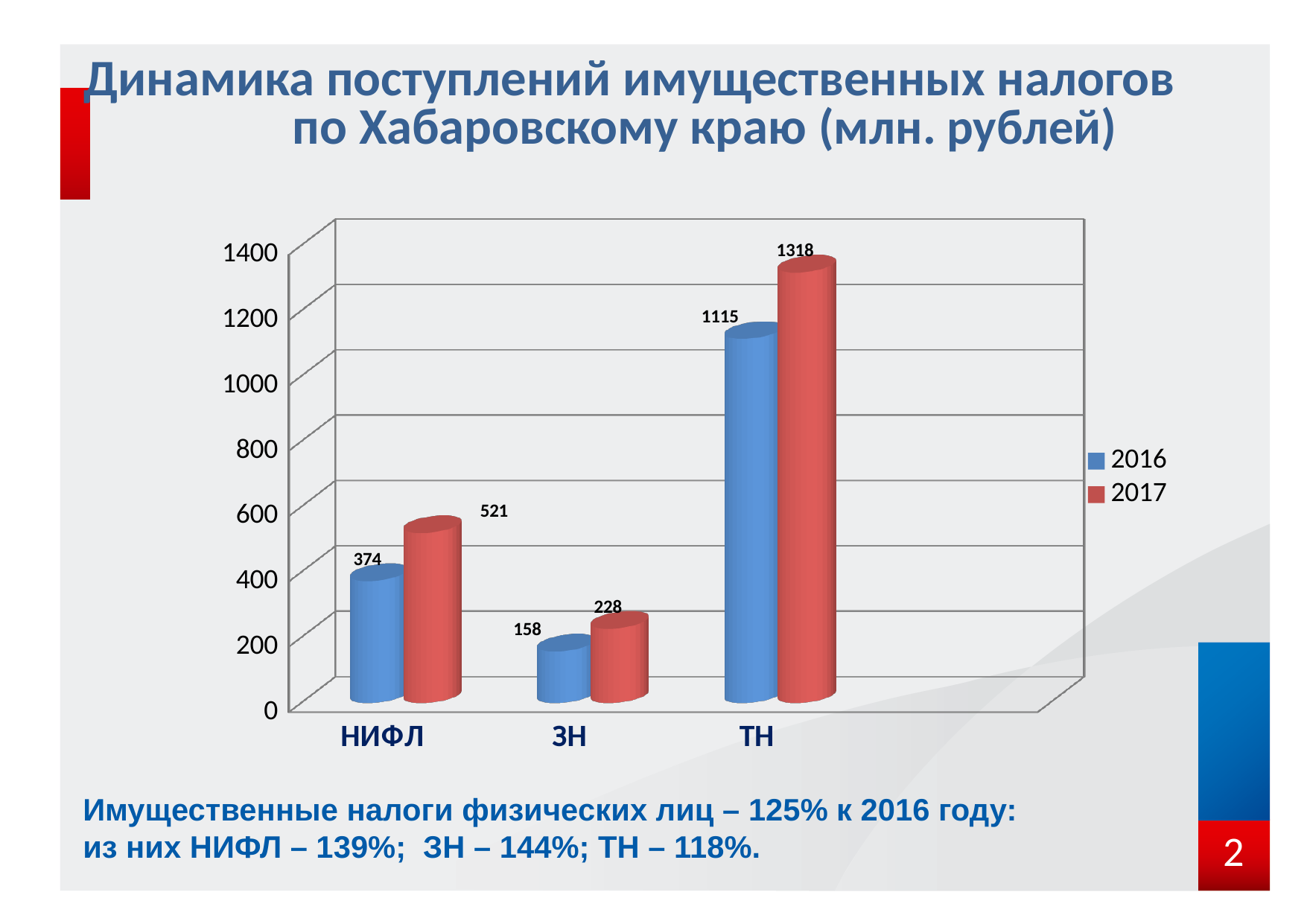
Which category has the highest value in 2017? ТН What kind of chart is shown on the slide? Bar chart Which category has the lowest value in 2016? ЗН What is the value for НИФЛ in 2016? 374 What is the difference between the 2017 and 2016 values for НИФЛ? 147 What is the difference between the 2017 and 2016 values for ТН? 203 What is the value for ТН in 2017? 1318 How many series does the legend list? 2 How many categories are shown on the x axis? 3 Which is larger: the 2017 value for ЗН or the 2016 value for НИФЛ? 2016 value for НИФЛ What is the value for ЗН in 2016? 158 Which colour represents the 2017 series? Red